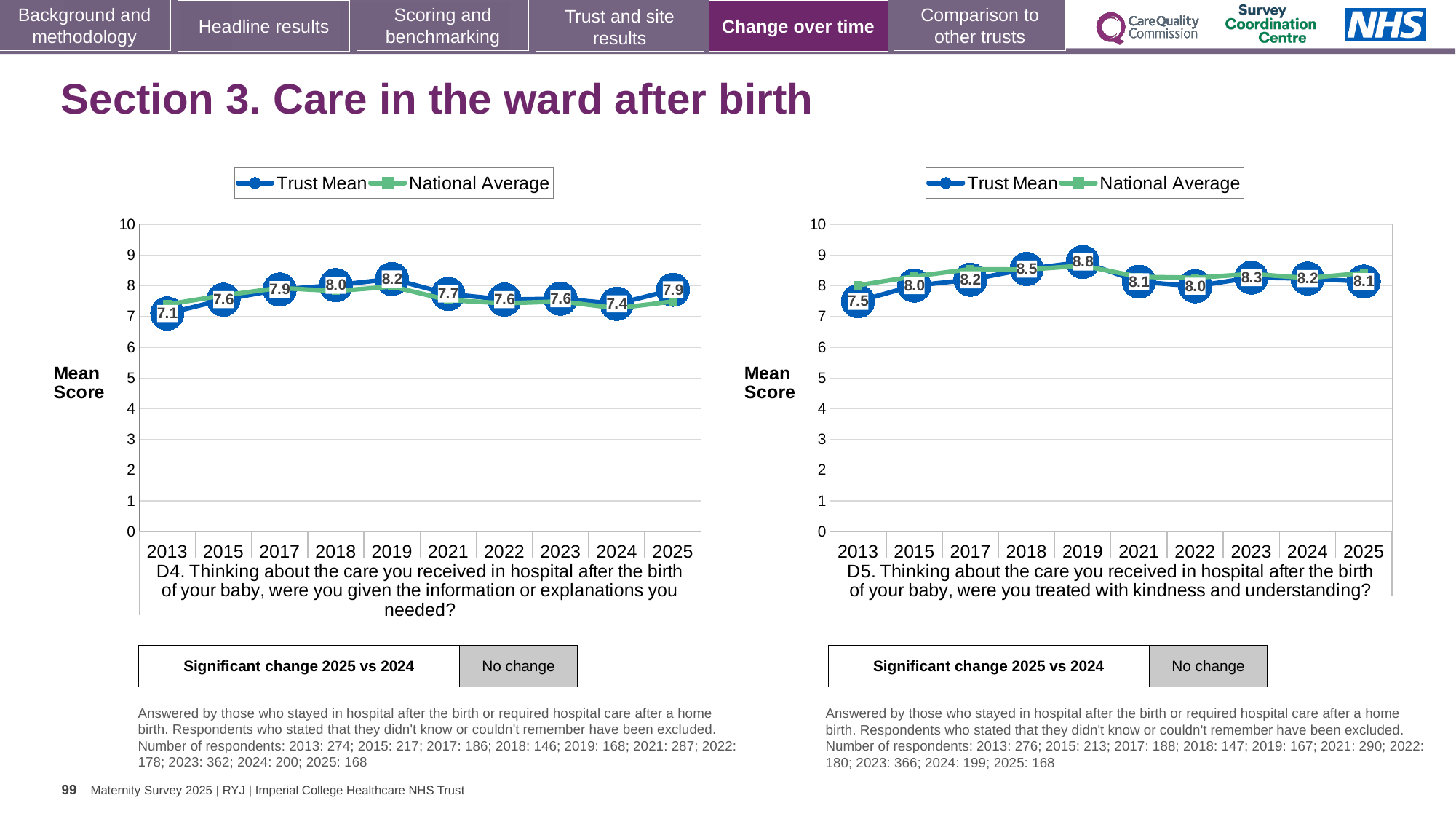
How many series does the legend of the right chart (D5) list? 2 In the right chart (D5), is the Trust Mean score higher in 2018 or in 2024? 2018 In the left chart (D4), what is the Trust Mean score for 2025? 7.9 How many years are plotted on the x axis of the left chart (D4)? 10 In the left chart (D4), what is the Trust Mean score for 2013? 7.1 In the left chart (D4), which year has the lowest Trust Mean score? 2013 In the right chart (D5), which year has the lowest Trust Mean score? 2013 In the left chart (D4), which year has the highest Trust Mean score? 2019 In the right chart (D5), what is the difference between the Trust Mean scores for 2025 and 2013? 0.6 In the right chart (D5), what is the Trust Mean score for 2022? 8.0 In the left chart (D4), what is the difference between the Trust Mean scores for 2019 and 2024? 0.8 In the right chart (D5), what is the Trust Mean score for 2019? 8.8